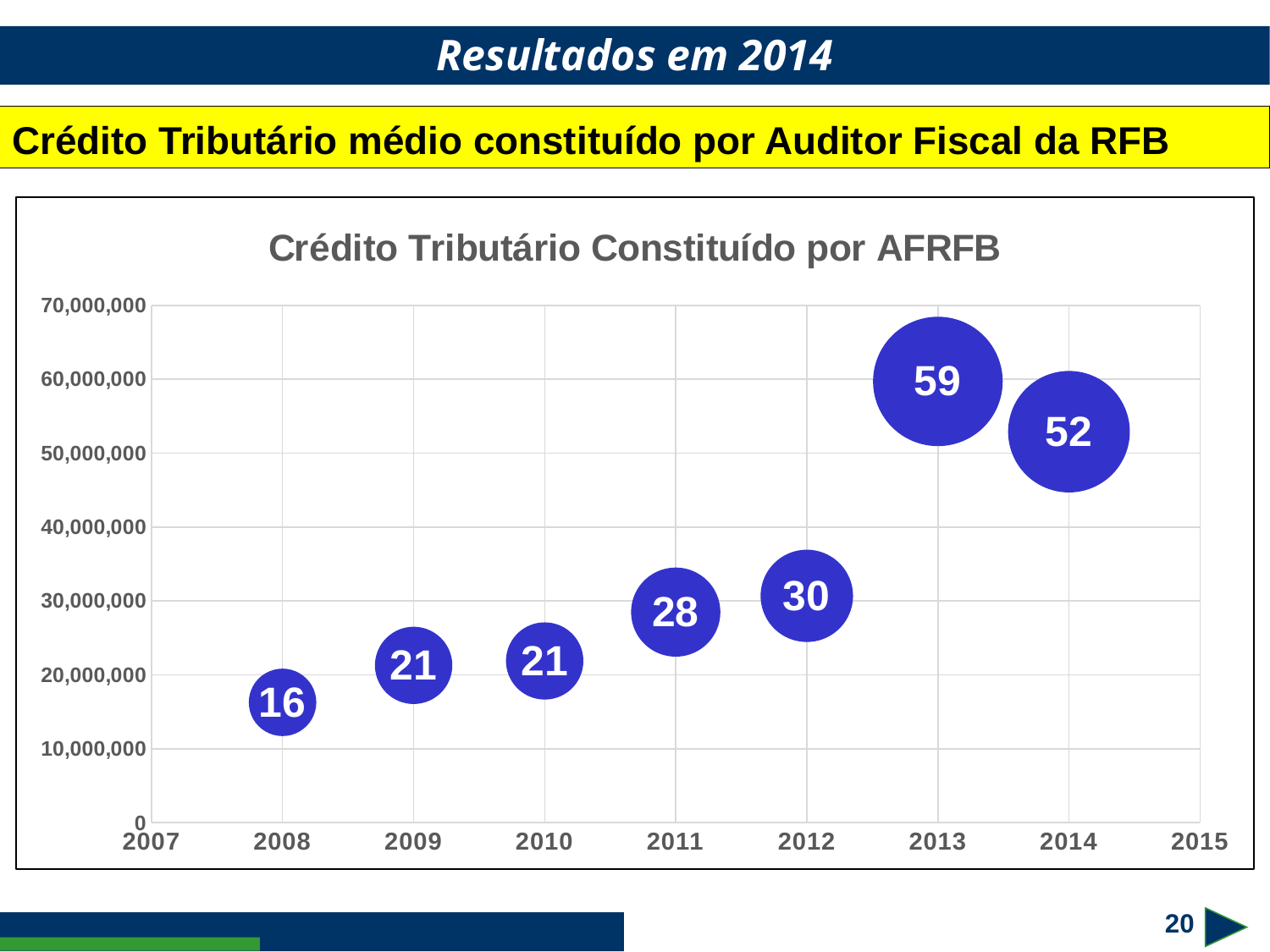
What is the data label shown for 2008 in the chart? 16 What is the data label shown for 2011 in the chart? 28 Is the value for 2013 greater or less than 50,000,000 on the y axis? greater Which year has the highest labelled value in the chart? 2013 What is the data label shown for 2014 in the chart? 52 What is the title of the chart? Crédito Tributário Constituído por AFRFB Which year has the lowest labelled value in the chart? 2008 What kind of chart is shown on the slide? bubble chart How many data points (bubbles) are plotted in the chart? 7 What is the data label shown for 2013 in the chart? 59 Which year has the larger labelled value, 2012 or 2011? 2012 What is the difference between the labelled values for 2013 and 2014? 7